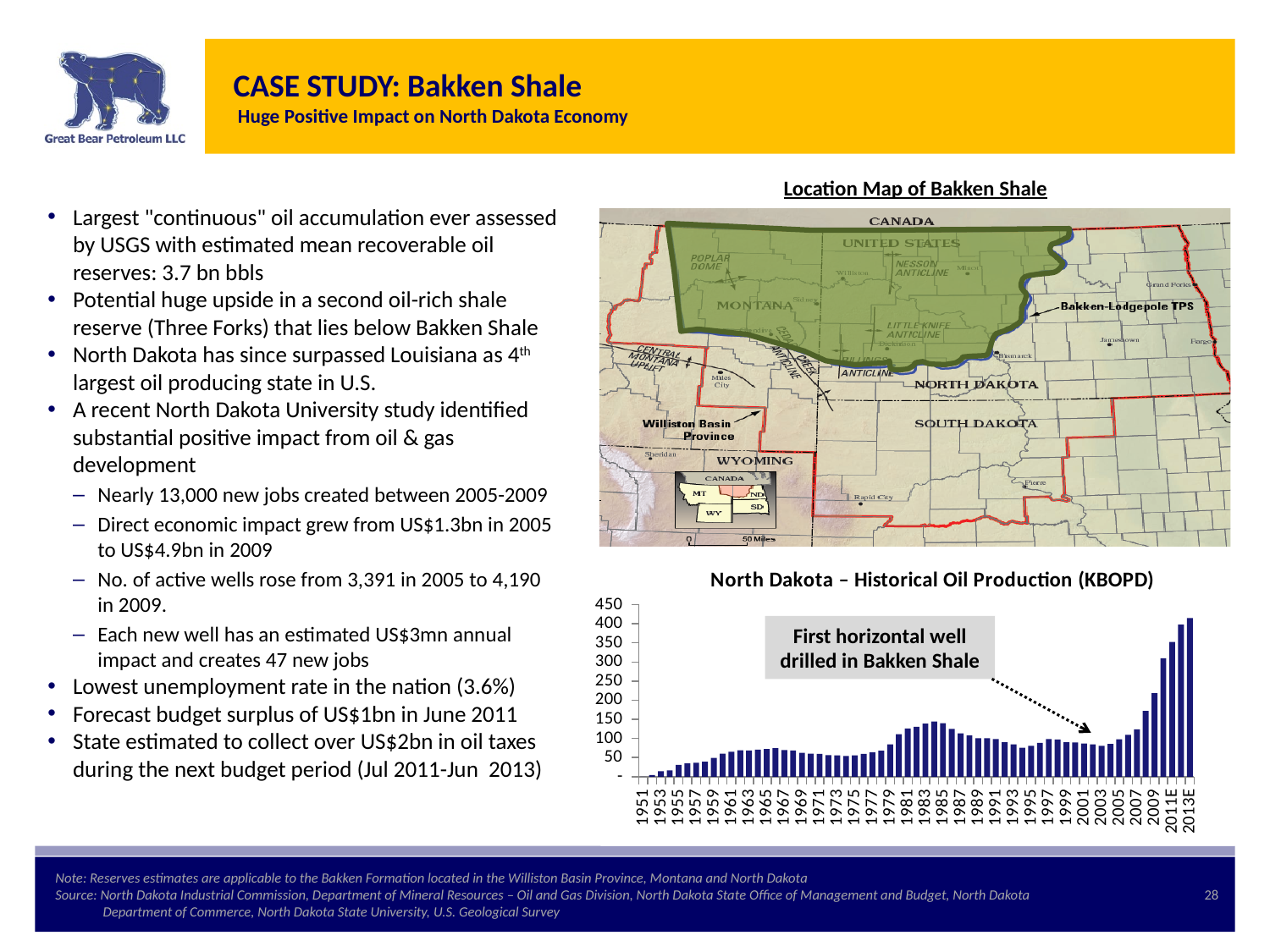
In the North Dakota oil production chart, do the values rise or fall from 2003 to 2013E? rise In the North Dakota oil production chart, is the value for 1985 greater or less than 100? greater In the North Dakota oil production chart, which is larger, the value for 1985 or the value for 2001? 1985 What kind of chart is the 'North Dakota – Historical Oil Production (KBOPD)' chart? bar chart In the North Dakota oil production chart, which year has the lowest production? 1951 What is the title of the chart at the bottom right of the slide? North Dakota – Historical Oil Production (KBOPD) In the North Dakota oil production chart, which year has the highest production? 2013E In the North Dakota oil production chart, is the value for 2013E greater or less than 350? greater In the North Dakota oil production chart, is the value for 2009 greater or less than 150? greater What event does the annotation on the North Dakota oil production chart point to? First horizontal well drilled in Bakken Shale